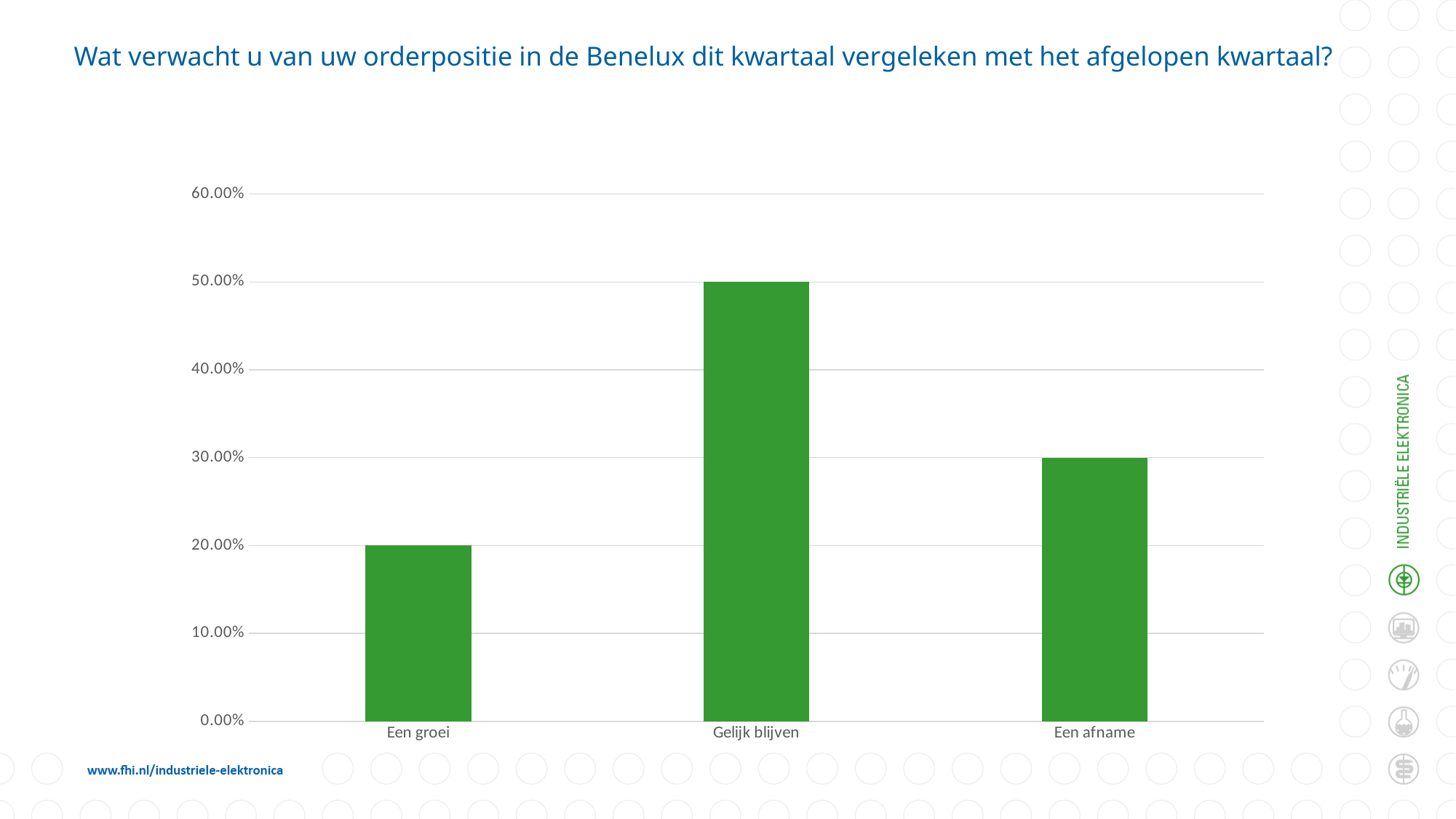
Is the value for Gelijk blijven greater or less than 40.00%? greater What is the difference between the values for Een afname and Een groei? 10.00% Which category has the lowest value? Een groei How many categories are shown on the x axis? 3 What colour are the bars in the chart? green What is the value for Een groei? 20.00% What is the difference between the values for Gelijk blijven and Een afname? 20.00% Which is larger, the value for Een groei or the value for Een afname? Een afname Which category has the highest value? Gelijk blijven What is the value for Een afname? 30.00% What is the value for Gelijk blijven? 50.00% What kind of chart is shown on the slide? bar chart